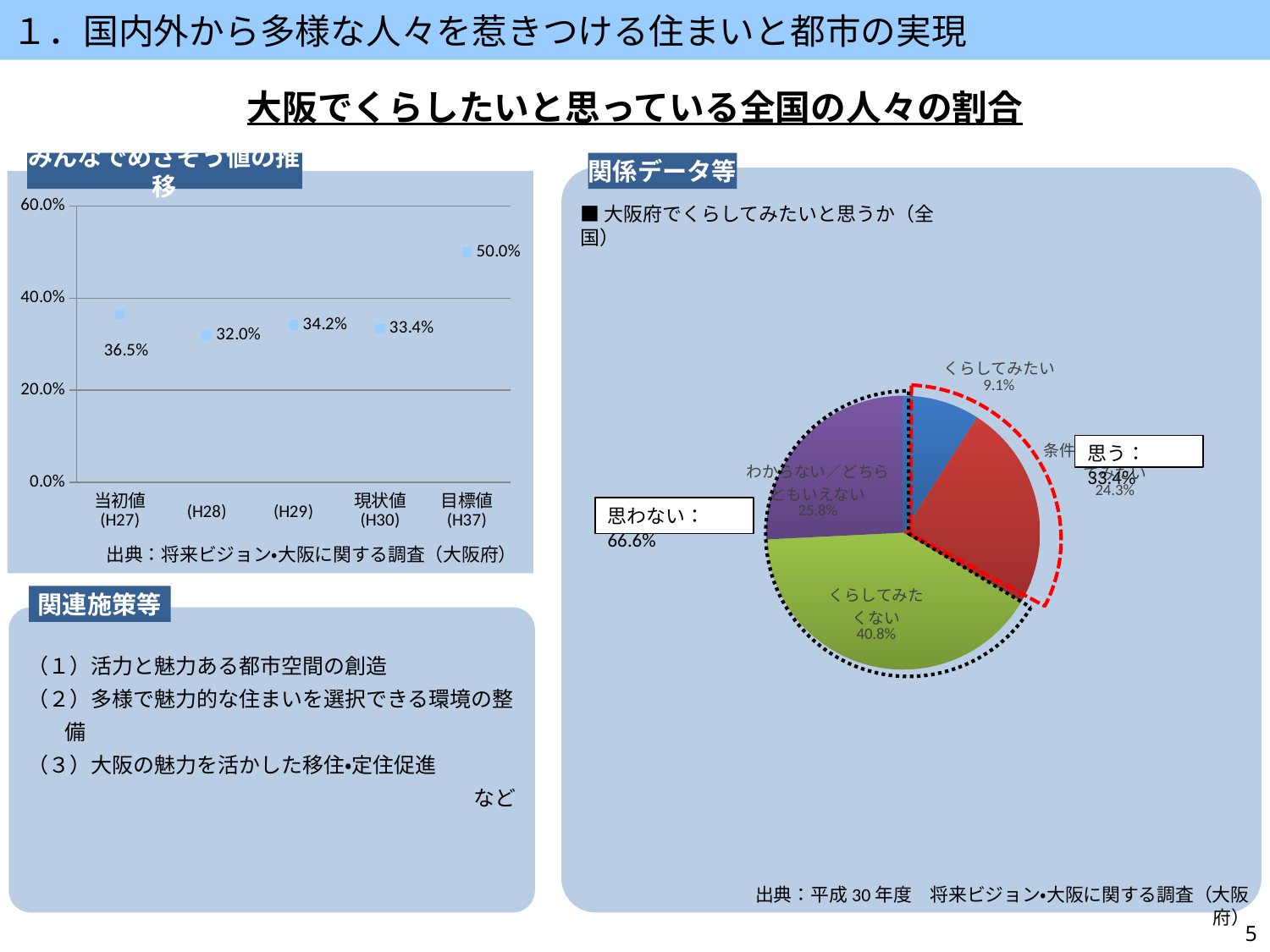
In the pie chart on the right, what share does くらしてみたくない have? 40.8% In the left chart (みんなでめざそう値の推移), which category has the highest value? 目標値 (H37) In the pie chart on the right, which slice is the largest? くらしてみたくない In the pie chart on the right, which slice is the smallest? くらしてみたい What kind of chart is shown on the right side of the slide? Pie chart In the left chart (みんなでめざそう値の推移), which category has the lowest value? (H28) In the left chart (みんなでめざそう値の推移), how many data points are plotted? 5 In the left chart (みんなでめざそう値の推移), what is the value for 現状値 (H30)? 33.4% In the left chart (みんなでめざそう値の推移), what is the value for 当初値 (H27)? 36.5% In the left chart (みんなでめざそう値の推移), what is the difference between the 目標値 (H37) value and the 現状値 (H30) value? 16.6 percentage points In the left chart (みんなでめざそう値の推移), which is larger, the value for (H29) or the value for (H28)? (H29) In the left chart (みんなでめざそう値の推移), what is the value for 目標値 (H37)? 50.0%